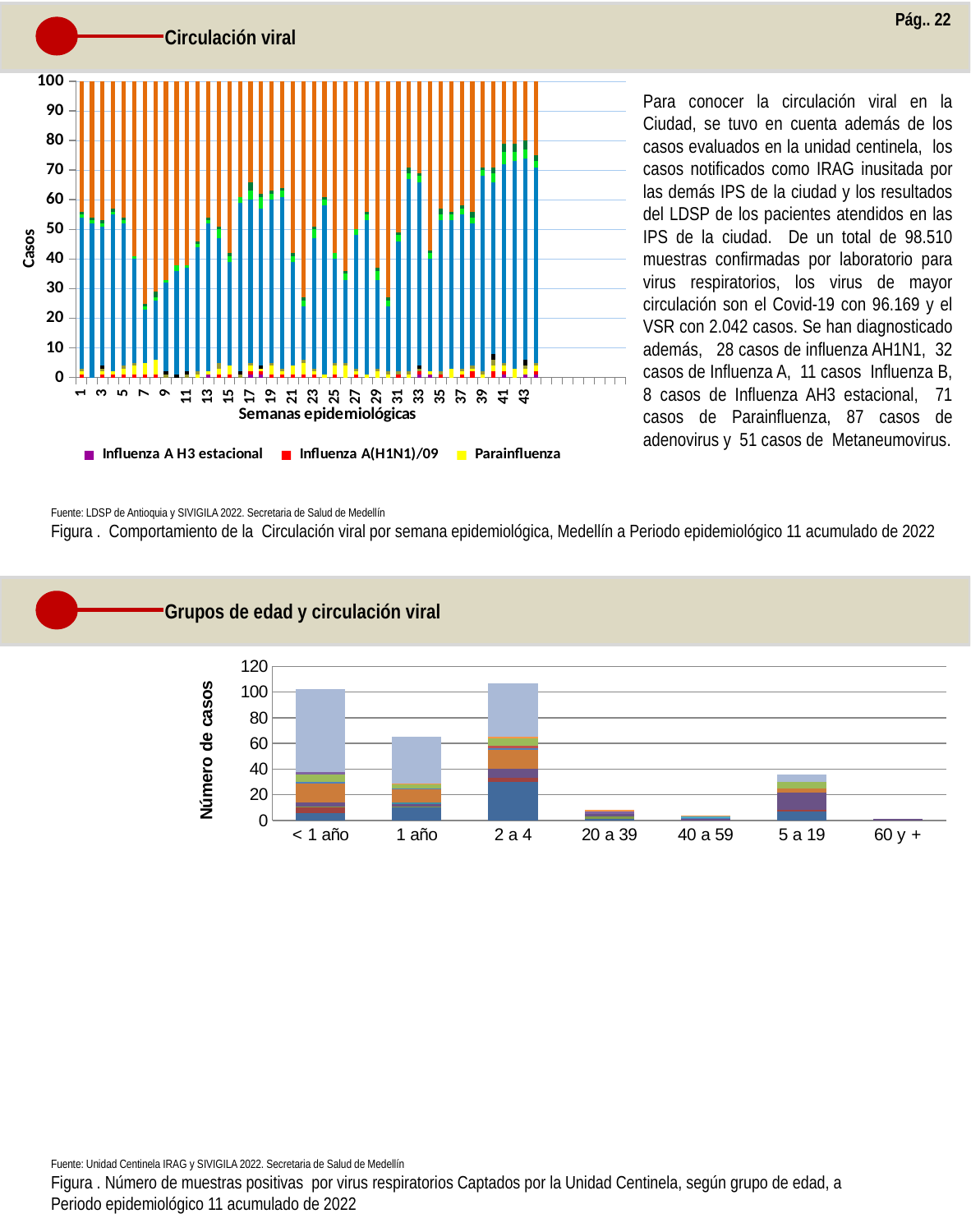
What kind of chart is the bottom chart under 'Grupos de edad y circulación viral'? bar chart In the top chart (Circulación viral), what is the title of the x axis? Semanas epidemiológicas In the bottom chart (by age group), which has the larger total: '1 año' or '5 a 19'? 1 año In the bottom chart (by age group), is the total for '2 a 4' greater or less than 100? greater What kind of chart is the top chart titled 'Circulación viral'? bar chart In the bottom chart (by age group), is the total for '20 a 39' greater or less than 20? less In the bottom chart (by age group), what is the title of the y axis? Número de casos In the bottom chart (by age group), is the total for '1 año' greater or less than 80? less In the bottom chart (by age group), which age group has the lowest total number of cases? 60 y + In the bottom chart (by age group), which has the larger total: '< 1 año' or '40 a 59'? < 1 año In the bottom chart (by age group), how many age-group categories are shown on the x axis? 7